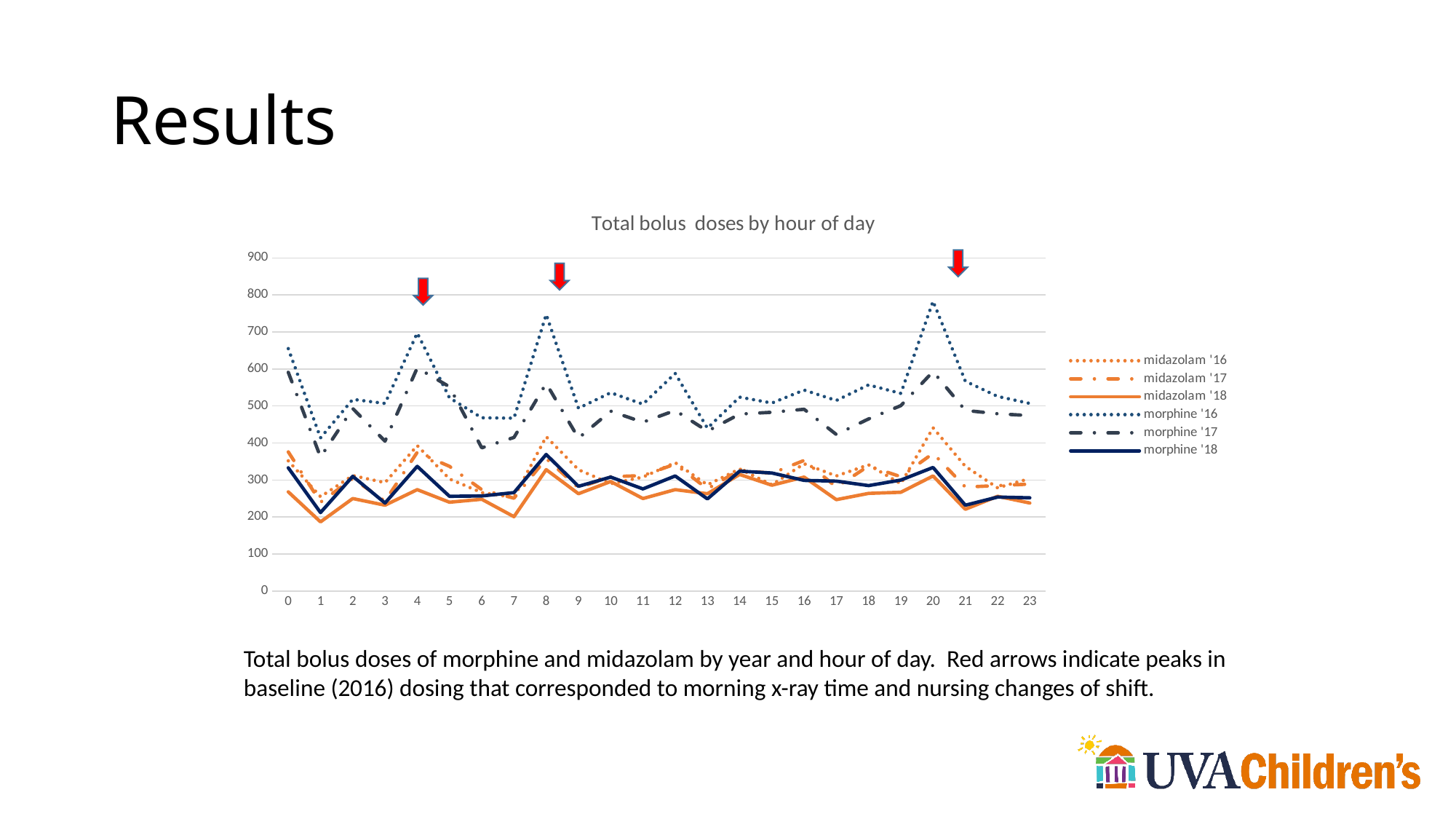
Does the morphine '16 series rise or fall from hour 20 to hour 23? fall How many series does the legend of the chart list? 6 Is the value for morphine '17 at hour 20 greater or less than 500? greater How many hours of the day are plotted along the x axis of the chart? 24 Is the value for midazolam '18 at hour 1 greater or less than 300? less At hour 20, which is larger: morphine '16 or morphine '18? morphine '16 Is the value for morphine '16 at hour 20 greater or less than 700? greater What kind of chart is shown on the slide? line chart At hour 0, which is larger: morphine '16 or morphine '17? morphine '16 What is the title of the chart? Total bolus doses by hour of day At which hour does the morphine '16 series reach its highest value? 20